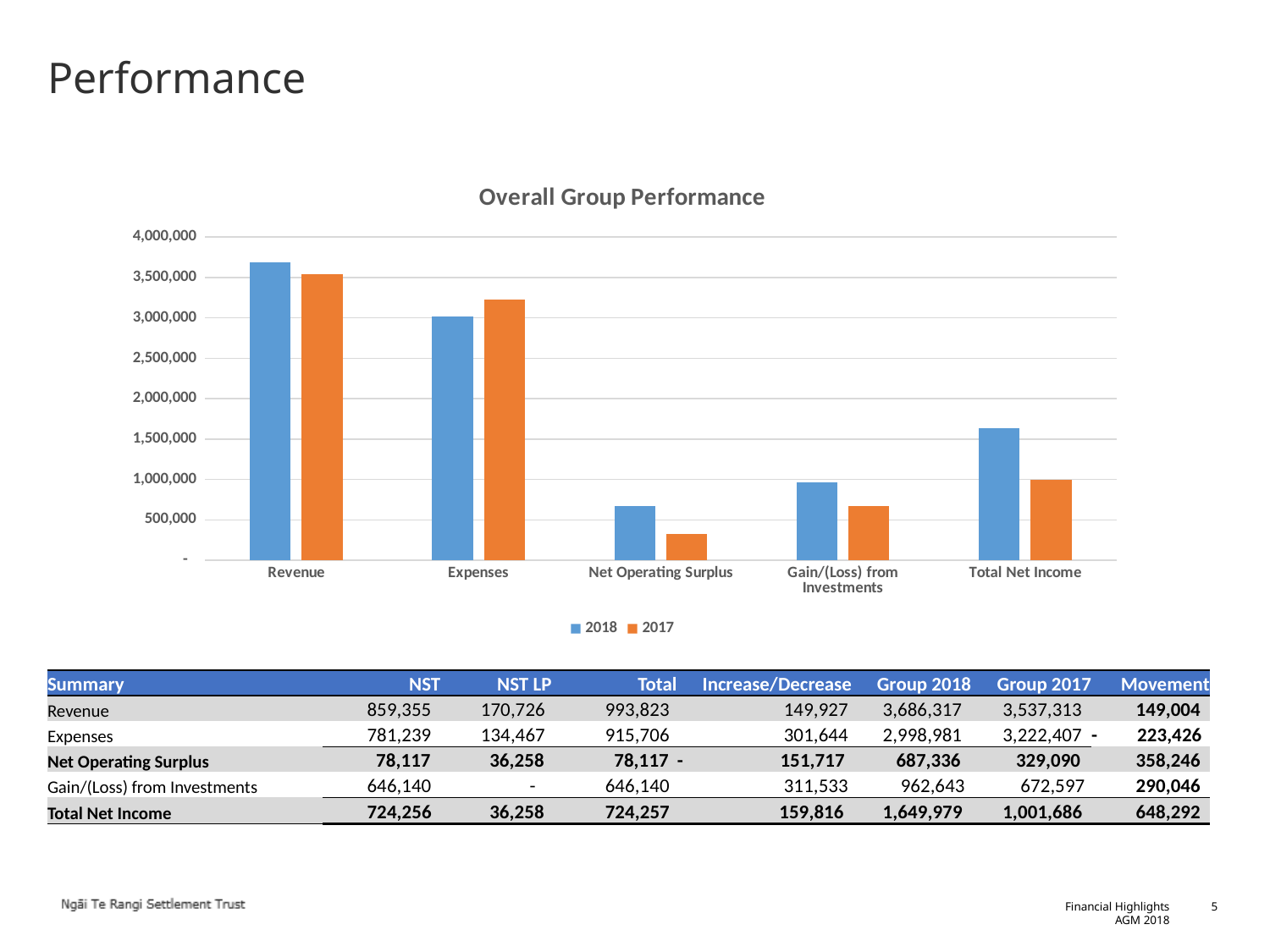
Is the 2018 value for Total Net Income greater or less than 1,500,000? greater For Expenses, which year has the larger bar, 2018 or 2017? 2017 For Total Net Income, which year has the larger bar, 2018 or 2017? 2018 What type of chart is shown on the slide? Bar chart Which category has the highest 2018 bar? Revenue Which colour represents the 2017 series in the chart? Orange Which category has the lowest 2017 bar? Net Operating Surplus What is the title of the chart? Overall Group Performance Which category has the lowest 2018 bar? Net Operating Surplus Is the 2017 value for Net Operating Surplus greater or less than 500,000? less How many series does the chart legend list? 2 How many categories are shown on the x axis of the chart? 5